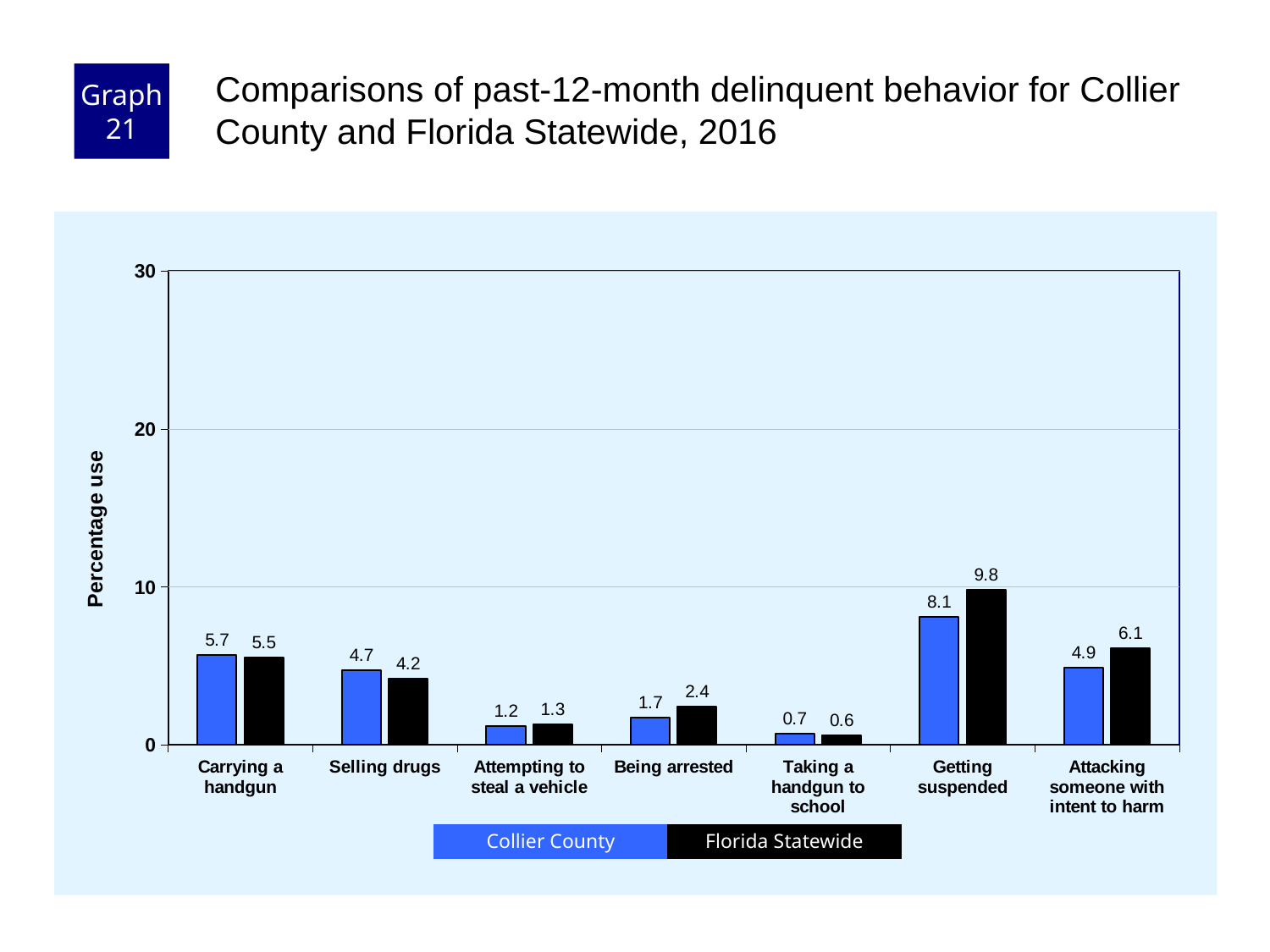
For Selling drugs, which is larger: the Collier County value or the Florida Statewide value? Collier County What is the difference between the Florida Statewide and Collier County values for Getting suspended? 1.7 How many categories are shown on the x axis? 7 What kind of chart is shown on the slide? Bar chart How many series does the legend list? 2 What is the Collier County value for Getting suspended? 8.1 Which category has the lowest Collier County value? Taking a handgun to school What is the Collier County value for Taking a handgun to school? 0.7 Which category has the highest Florida Statewide value? Getting suspended Is the Florida Statewide value for Getting suspended greater or less than 10? less What is the Florida Statewide value for Being arrested? 2.4 What is the difference between the Florida Statewide and Collier County values for Attacking someone with intent to harm? 1.2